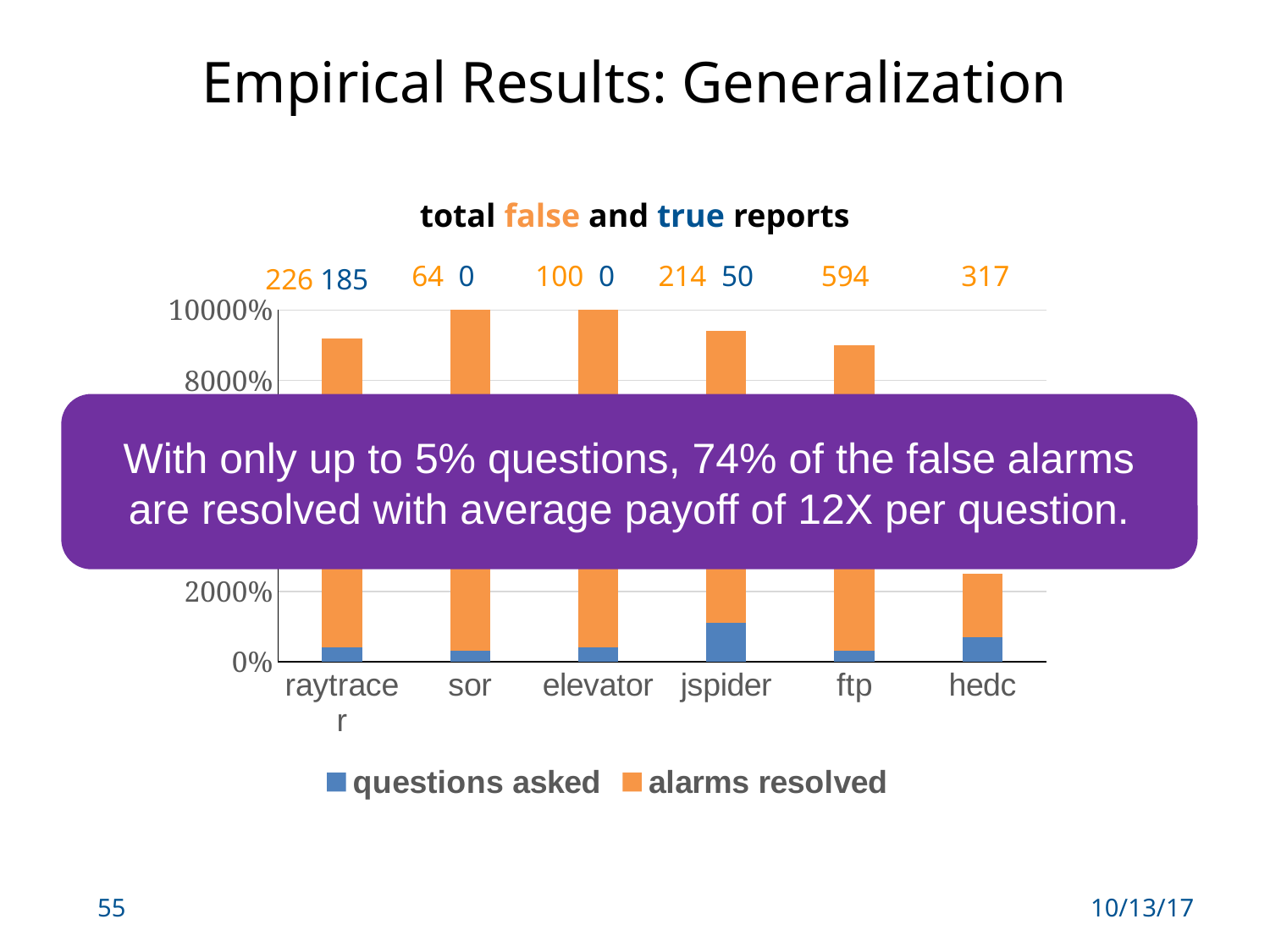
What is the title of the chart? total false and true reports Which category has the lowest total stacked bar? hedc What are the two series named in the legend? questions asked, alarms resolved How many series does the legend list? 2 Is the total stacked value for hedc greater or less than 4000%? less Which has the larger 'questions asked' value, jspider or sor? jspider Is the total stacked value for ftp greater or less than 8000%? greater How many benchmark categories are shown on the x axis? 6 According to the numbers printed above the chart, how many false reports are listed for ftp? 594 Is the total stacked value for raytracer greater or less than 8000%? greater According to the numbers printed above the chart, how many true reports are listed for raytracer? 185 What kind of chart is shown on the slide? bar chart